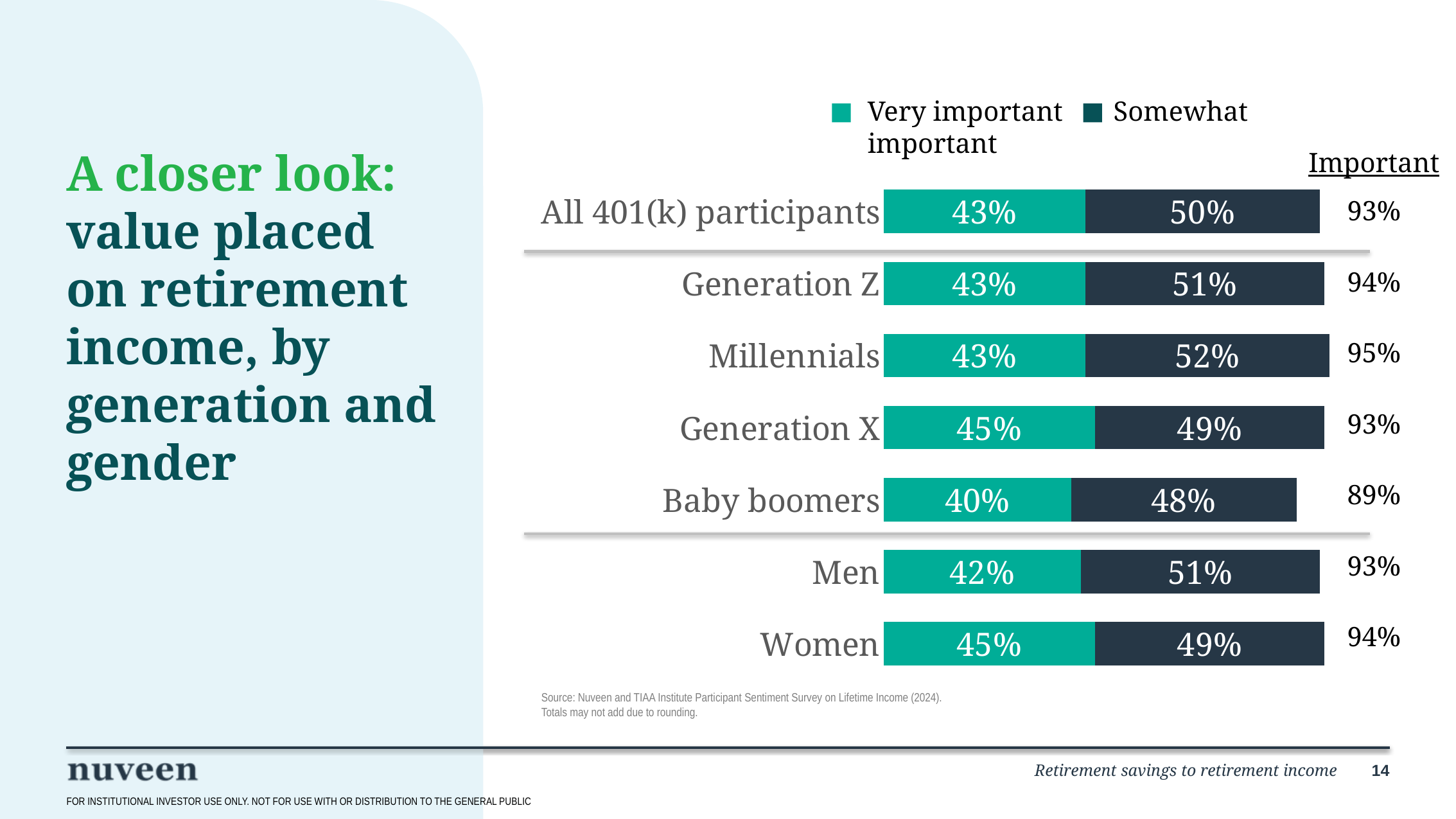
Which category has the highest "Important" total? Millennials What is the combined "Important" total for Baby boomers? 89% Which is larger, the "Very important" value for Women or for Men? Women What percentage of Millennials say retirement income is "Somewhat important"? 52% How many categories are shown in the chart? 7 What kind of chart is shown on the slide? Stacked bar chart How many series does the legend list? 2 Which category has the lowest "Very important" value? Baby boomers What percentage of Baby boomers say retirement income is "Very important"? 40% Which series is shown in the darker colour in the legend? Somewhat important What is the difference between the "Very important" values for Generation X and Baby boomers? 5% What is the "Important" total shown for Women? 94%